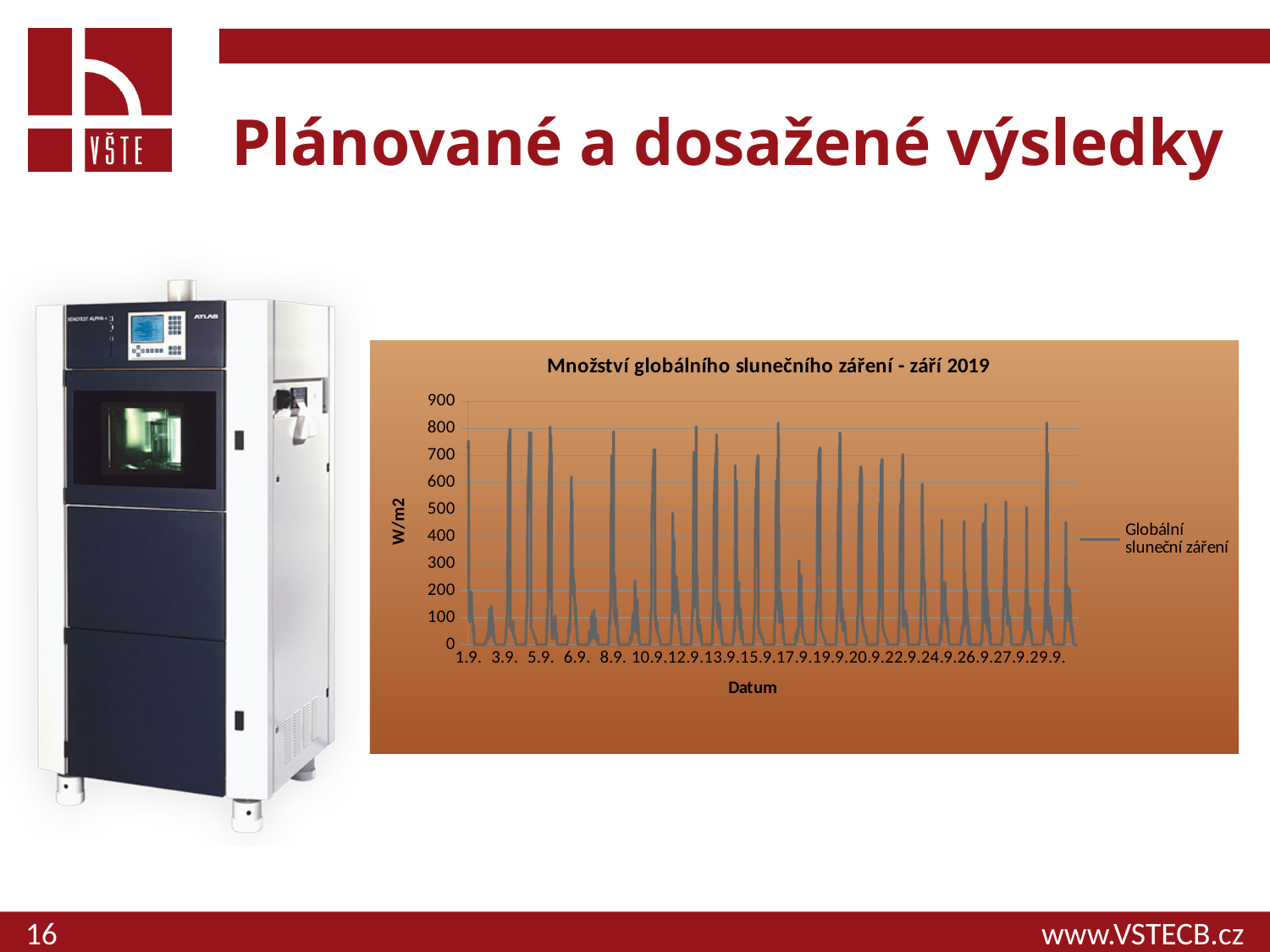
What is the first date label on the horizontal axis of the chart? 1.9. What is the title of the chart? Množství globálního slunečního záření - září 2019 Is the highest peak of global solar radiation in the chart greater or less than 900 W/m2? less How many series does the chart legend list? 1 What is the label of the series shown in the chart legend? Globální sluneční záření Is the lowest value of global solar radiation in the chart greater or less than 100 W/m2? less What is the label of the vertical axis of the chart? W/m2 What is the last date label on the horizontal axis of the chart? 29.9. What is the highest value shown on the vertical axis of the chart? 900 What kind of chart is shown on the slide? line chart How many date labels are printed on the horizontal axis of the chart? 17 What is the label of the horizontal axis of the chart? Datum